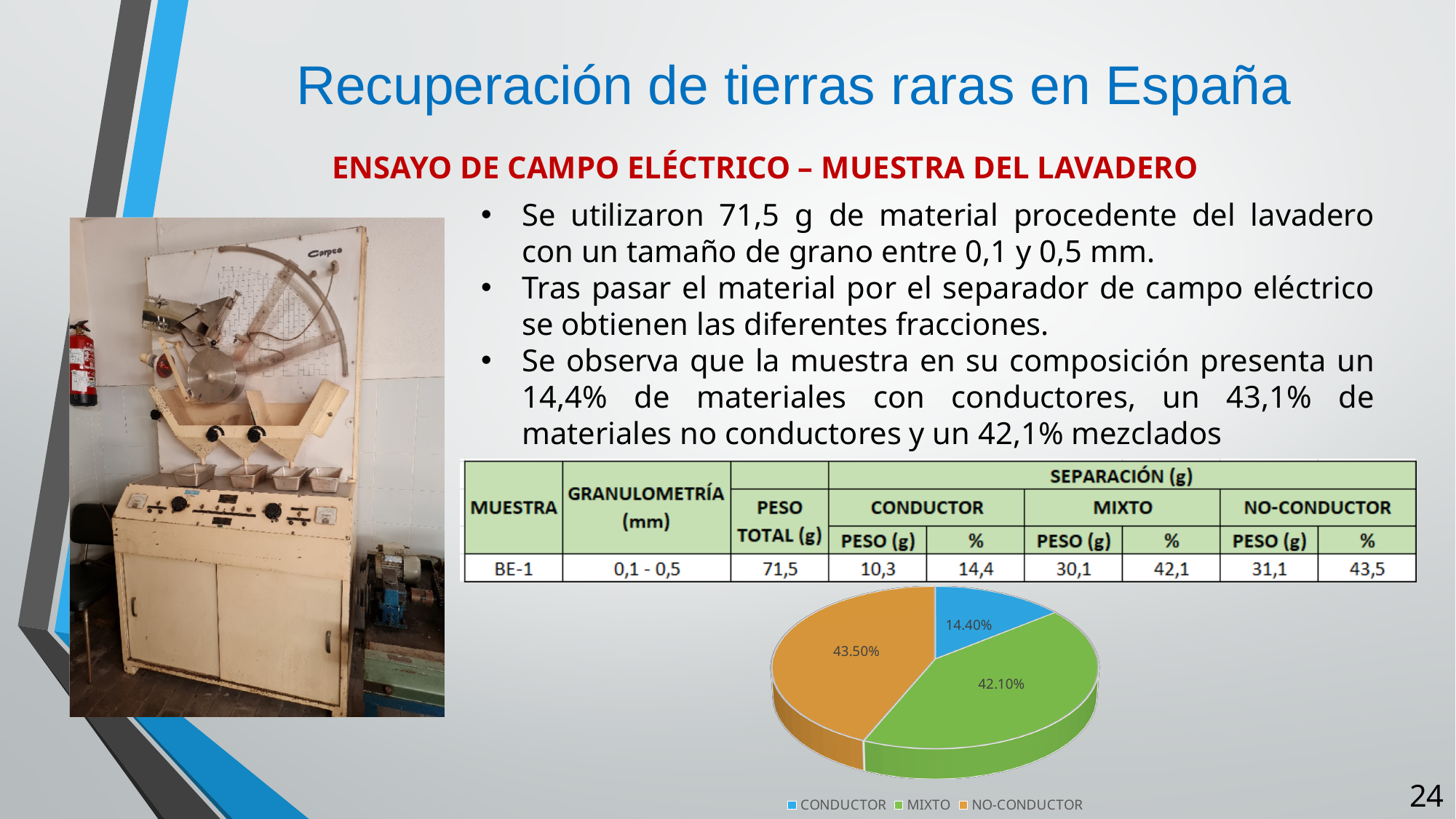
What percentage does the MIXTO slice of the pie chart show? 42.10% What percentage does the CONDUCTOR slice of the pie chart show? 14.40% Which is larger in the pie chart, the MIXTO slice or the CONDUCTOR slice? MIXTO Which category has the smallest slice in the pie chart? CONDUCTOR What percentage does the NO-CONDUCTOR slice of the pie chart show? 43.50% How many slices does the pie chart have? 3 What kind of chart is shown on the slide? Pie chart What is the difference between the NO-CONDUCTOR and MIXTO percentages in the pie chart? 1.40% What is the difference between the MIXTO and CONDUCTOR percentages in the pie chart? 27.70% What colour is the CONDUCTOR slice in the pie chart? Blue Which category has the largest slice in the pie chart? NO-CONDUCTOR How many entries does the pie chart's legend list? 3